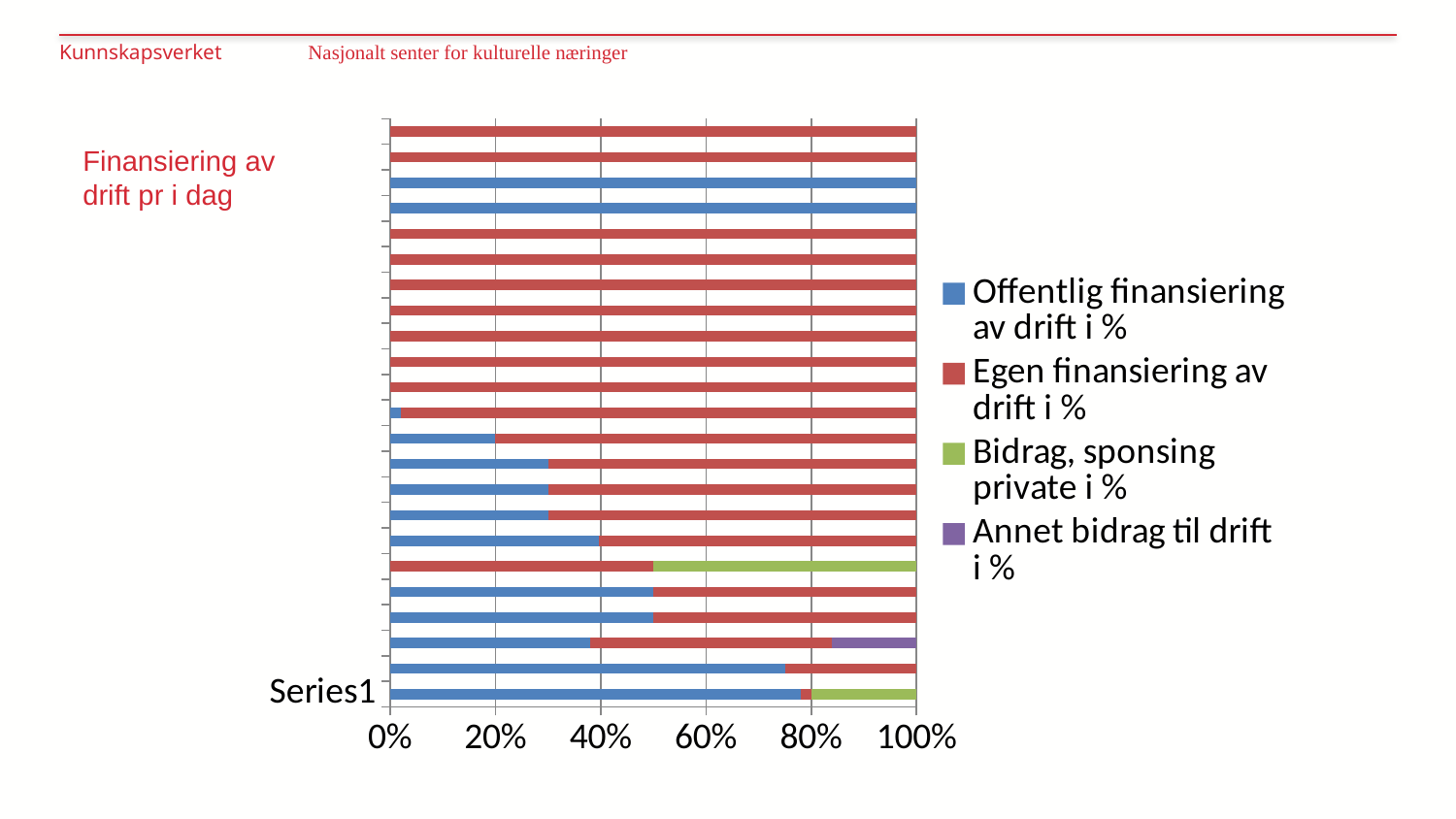
Is the value of Egen finansiering av drift i % for Series1 greater or less than 20%? less Is the value of Offentlig finansiering av drift i % for Series1 greater or less than 60%? greater What kind of chart is shown on the slide? Stacked bar chart How many series does the legend list? 4 Which series is shown in blue in the legend? Offentlig finansiering av drift i % What is the highest value shown on the x axis? 100% For Series1, which is larger: Offentlig finansiering av drift i % or Egen finansiering av drift i %? Offentlig finansiering av drift i %